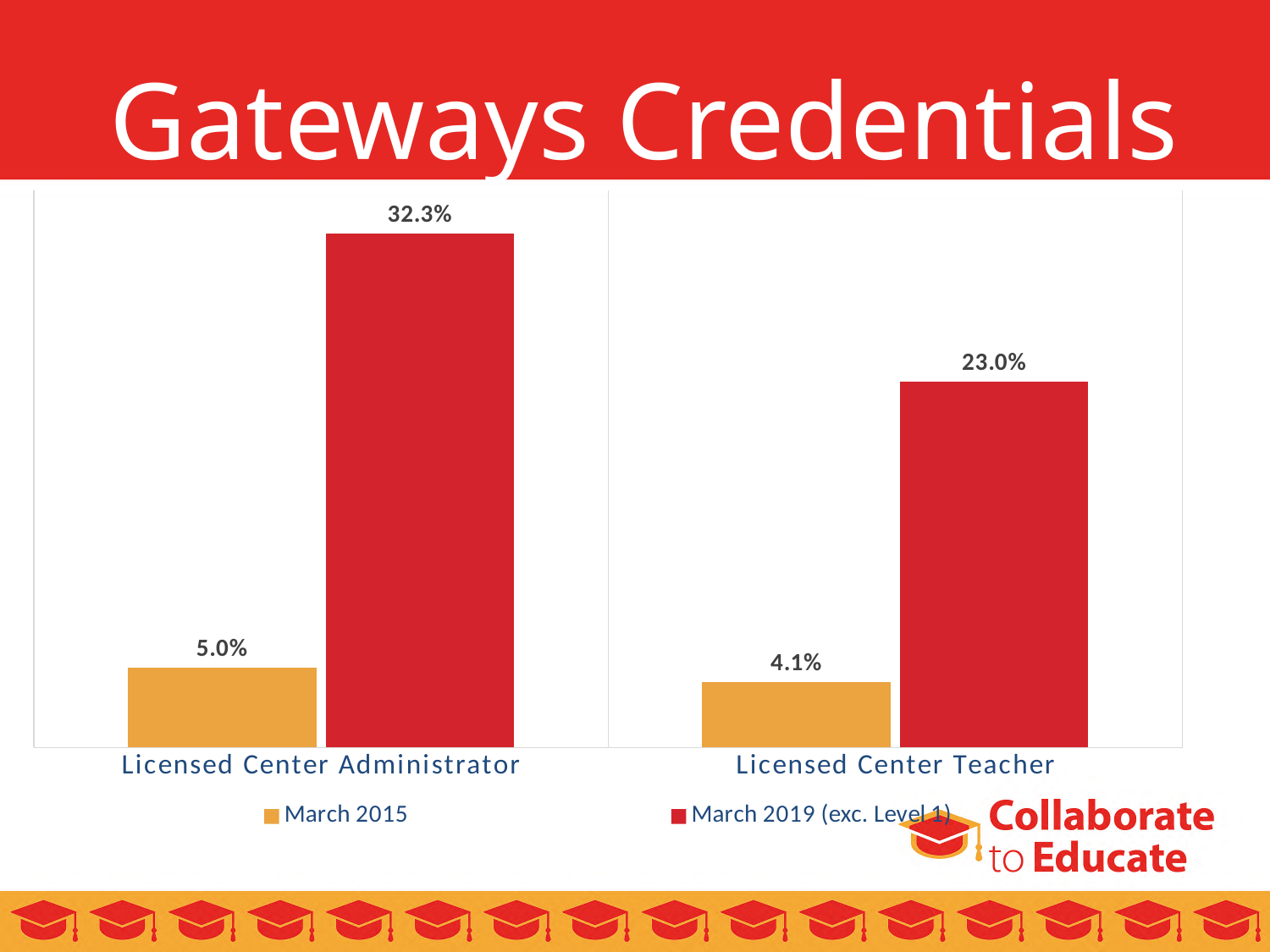
What kind of chart is shown on the slide? Bar chart Which category has the highest March 2019 (exc. Level 1) value? Licensed Center Administrator What is the March 2019 (exc. Level 1) value for Licensed Center Administrator? 32.3% How many series does the legend list? 2 Which category has the lowest March 2015 value? Licensed Center Teacher Which is larger: the March 2019 (exc. Level 1) value for Licensed Center Administrator or for Licensed Center Teacher? Licensed Center Administrator What is the difference between the March 2019 (exc. Level 1) and March 2015 values for Licensed Center Teacher? 18.9% How many categories are shown on the x axis? 2 What is the difference between the March 2019 (exc. Level 1) and March 2015 values for Licensed Center Administrator? 27.3% What is the March 2019 (exc. Level 1) value for Licensed Center Teacher? 23.0% What is the March 2015 value for Licensed Center Administrator? 5.0% What is the March 2015 value for Licensed Center Teacher? 4.1%